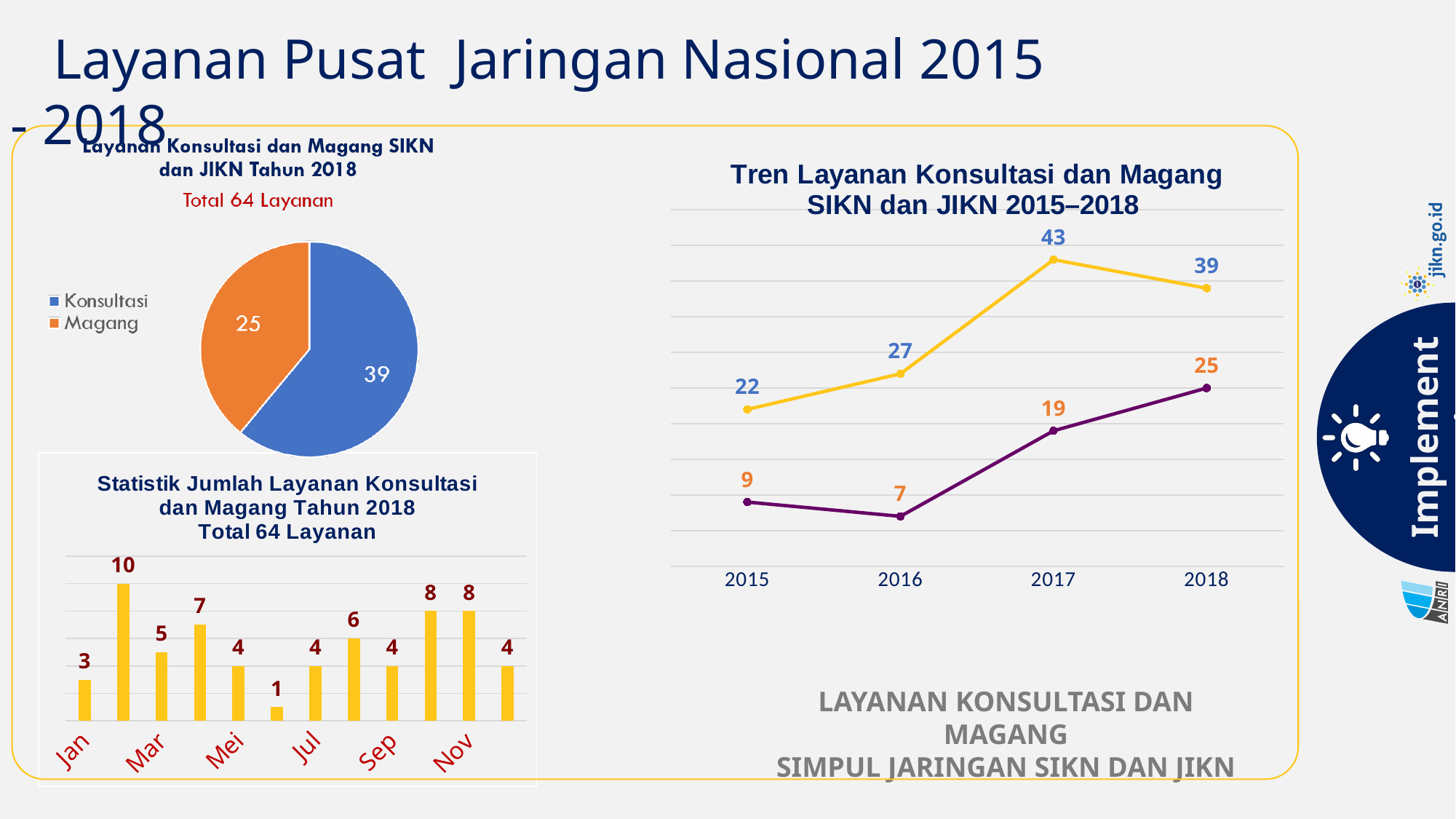
In the pie chart 'Layanan Konsultasi dan Magang SIKN dan JIKN Tahun 2018', how many categories does the legend list? 2 In the pie chart 'Layanan Konsultasi dan Magang SIKN dan JIKN Tahun 2018', what is the value for Magang? 25 In the line chart 'Tren Layanan Konsultasi dan Magang SIKN dan JIKN 2015–2018', what is the value of the yellow line in 2017? 43 In the bar chart 'Statistik Jumlah Layanan Konsultasi dan Magang Tahun 2018', what is the highest monthly value shown? 10 In the pie chart 'Layanan Konsultasi dan Magang SIKN dan JIKN Tahun 2018', which category has the larger slice? Konsultasi In the line chart 'Tren Layanan Konsultasi dan Magang SIKN dan JIKN 2015–2018', what is the difference between the yellow line and the purple line in 2015? 13 In the bar chart 'Statistik Jumlah Layanan Konsultasi dan Magang Tahun 2018', what is the lowest monthly value shown? 1 In the line chart 'Tren Layanan Konsultasi dan Magang SIKN dan JIKN 2015–2018', does the purple line rise or fall from 2016 to 2018? rise In the pie chart 'Layanan Konsultasi dan Magang SIKN dan JIKN Tahun 2018', what is the difference between Konsultasi and Magang? 14 In the bar chart 'Statistik Jumlah Layanan Konsultasi dan Magang Tahun 2018', what is the value for Jan? 3 In the bar chart 'Statistik Jumlah Layanan Konsultasi dan Magang Tahun 2018', how many bars are plotted? 12 In the pie chart 'Layanan Konsultasi dan Magang SIKN dan JIKN Tahun 2018', what is the value for Konsultasi? 39